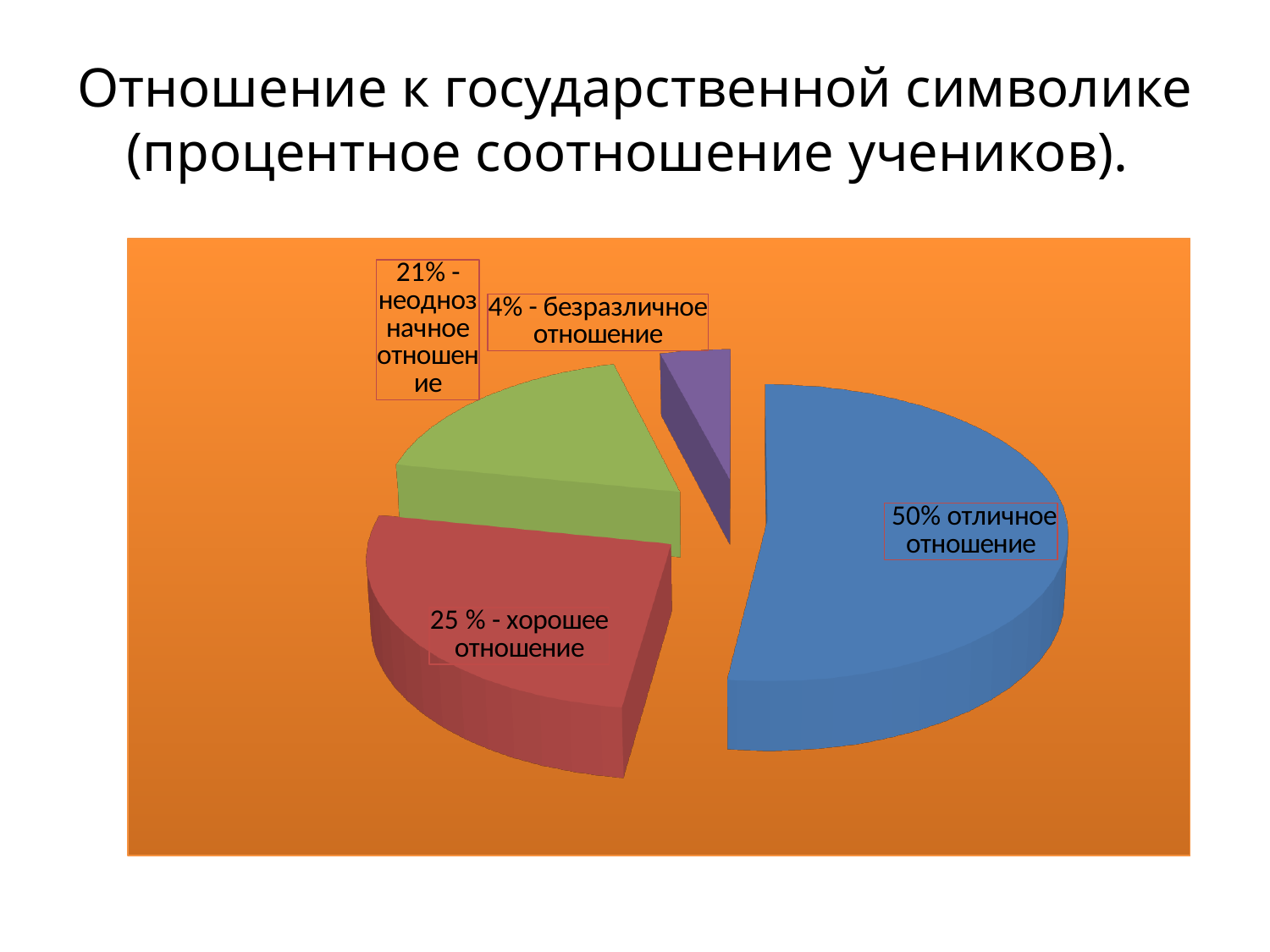
What share of the pie is labelled "безразличное отношение"? 4% What share of the pie is labelled "неоднозначное отношение"? 21% Which is larger: the slice for "хорошее отношение" or the slice for "неоднозначное отношение"? хорошее отношение What is the difference in percentage points between the "отличное отношение" slice and the "хорошее отношение" slice? 25 Which category has the smallest slice of the pie? безразличное отношение Which category has the largest slice of the pie? отличное отношение What kind of chart is shown on the slide? Pie chart What share of the pie is labelled "отличное отношение"? 50% What is the difference in percentage points between the "хорошее отношение" slice and the "неоднозначное отношение" slice? 4 How many slices does the pie chart have? 4 What is the title of the chart on the slide? Отношение к государственной символике (процентное соотношение учеников).